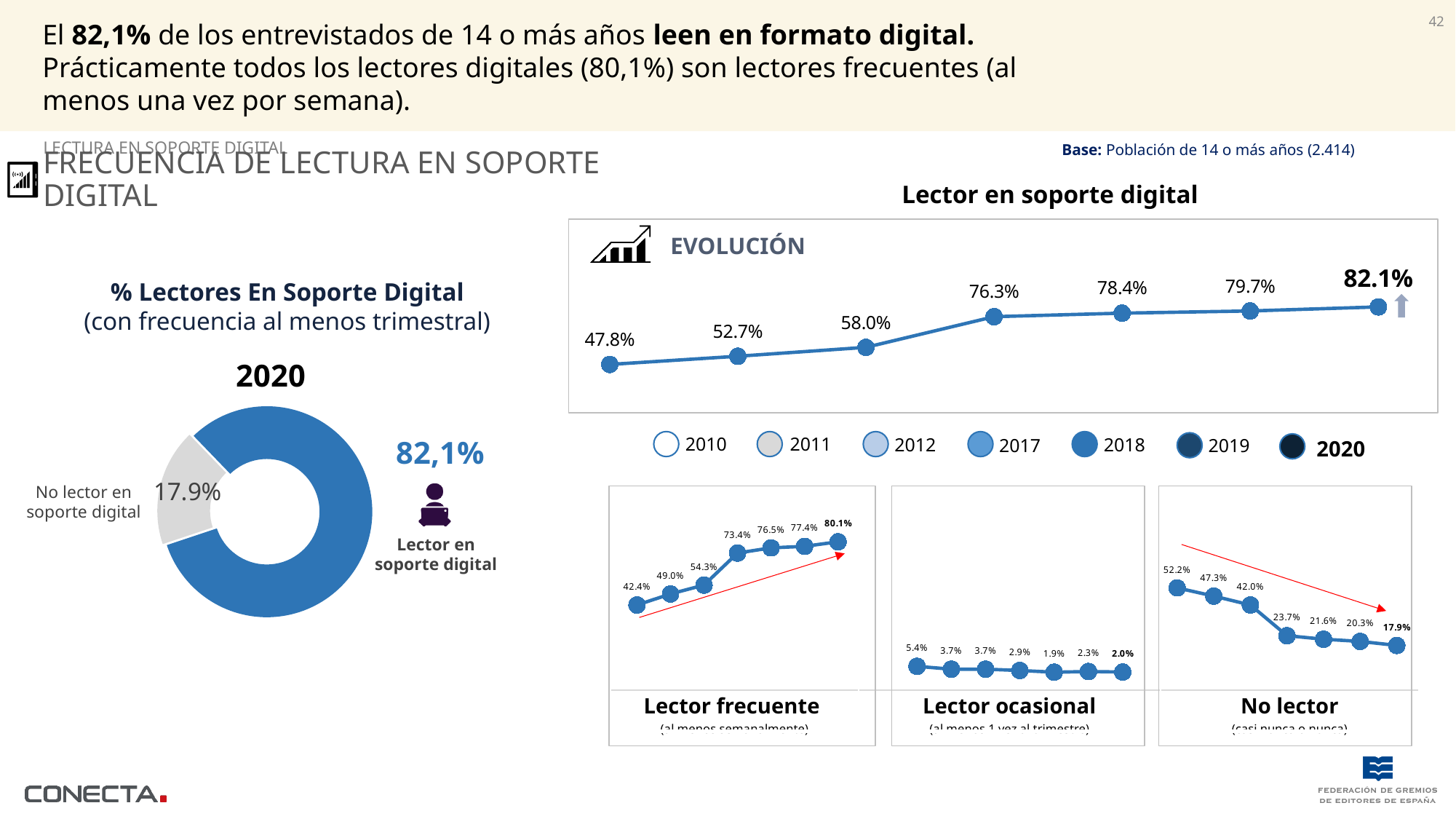
In the 'Lector en soporte digital' evolution line chart, what is the difference between the 2020 value and the 2010 value? 34.3 percentage points In the 'Lector ocasional' small line chart, what is the first (2010) value? 5.4% In the 'Lector frecuente' small line chart, what is the last (2020) value? 80.1% What kind of chart is the '% Lectores En Soporte Digital' chart on the left? Doughnut (pie) chart In the 'Lector en soporte digital' evolution line chart, what is the value for 2010? 47.8% In the 'No lector' small line chart, do the values rise or fall over time? fall In the '% Lectores En Soporte Digital' doughnut chart, what share is 'No lector en soporte digital'? 17.9% In the 'Lector en soporte digital' evolution line chart, do the values rise or fall from 2010 to 2020? rise In the 'Lector en soporte digital' evolution line chart, what is the value for 2017? 76.3% In the 'No lector' small line chart, what is the difference between the first value (52.2%) and the last value (17.9%)? 34.3 percentage points How many years does the legend of the 'Lector en soporte digital' evolution chart list? 7 In the 'Lector en soporte digital' evolution line chart, which year has the highest value? 2020